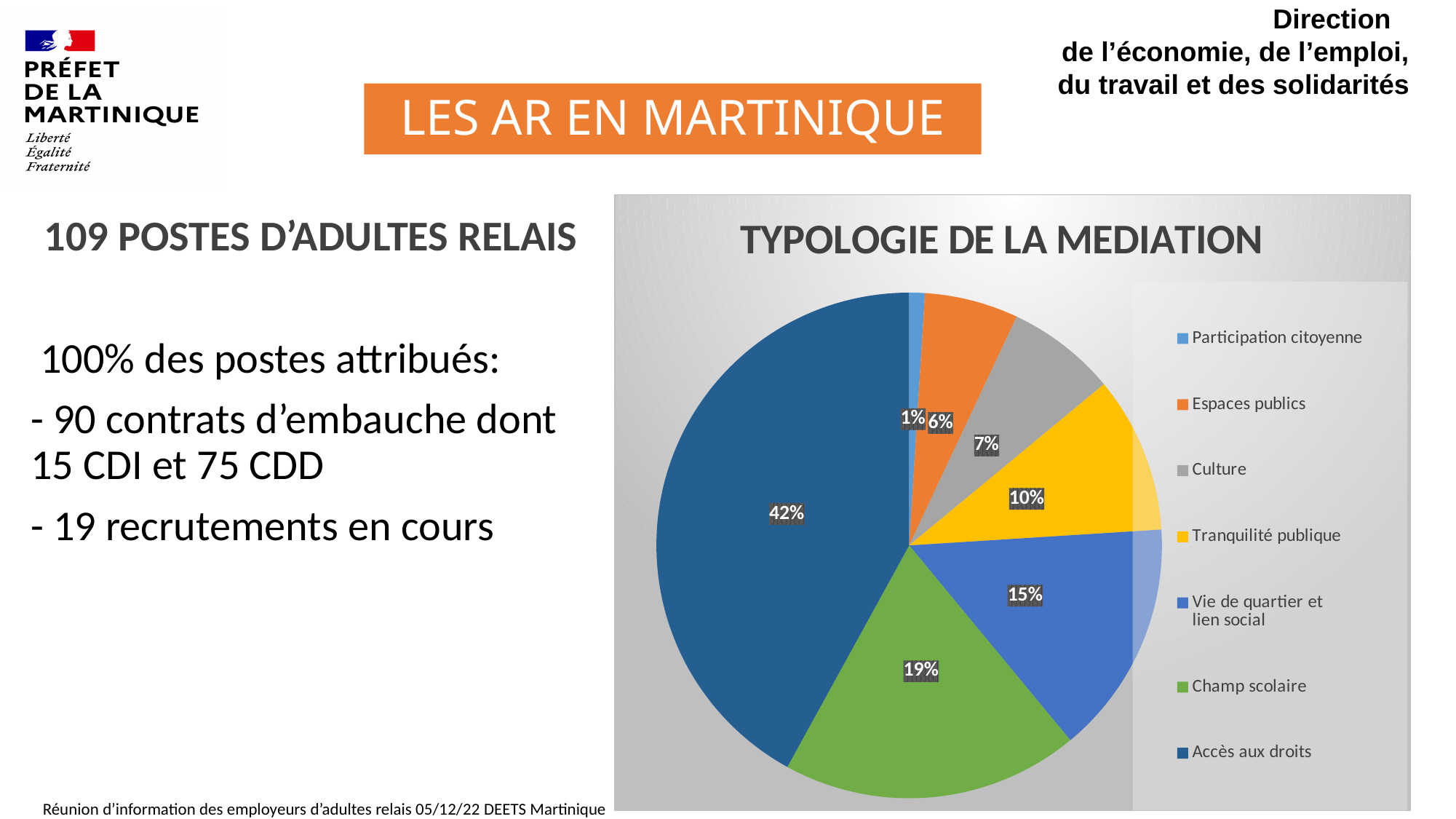
Which category has the smallest share of the pie? Participation citoyenne What is the value for Tranquilité publique? 10% What type of chart is shown on the slide? pie chart How many categories does the legend list? 7 What is the value for Vie de quartier et lien social? 15% What is the value for Culture? 7% What is the value for Champ scolaire? 19% Which category has the largest share of the pie? Accès aux droits What is the title of the chart? TYPOLOGIE DE LA MEDIATION What is the difference in percentage points between Accès aux droits and Champ scolaire? 23 What share of the pie does Accès aux droits represent? 42% What is the value for Espaces publics? 6%